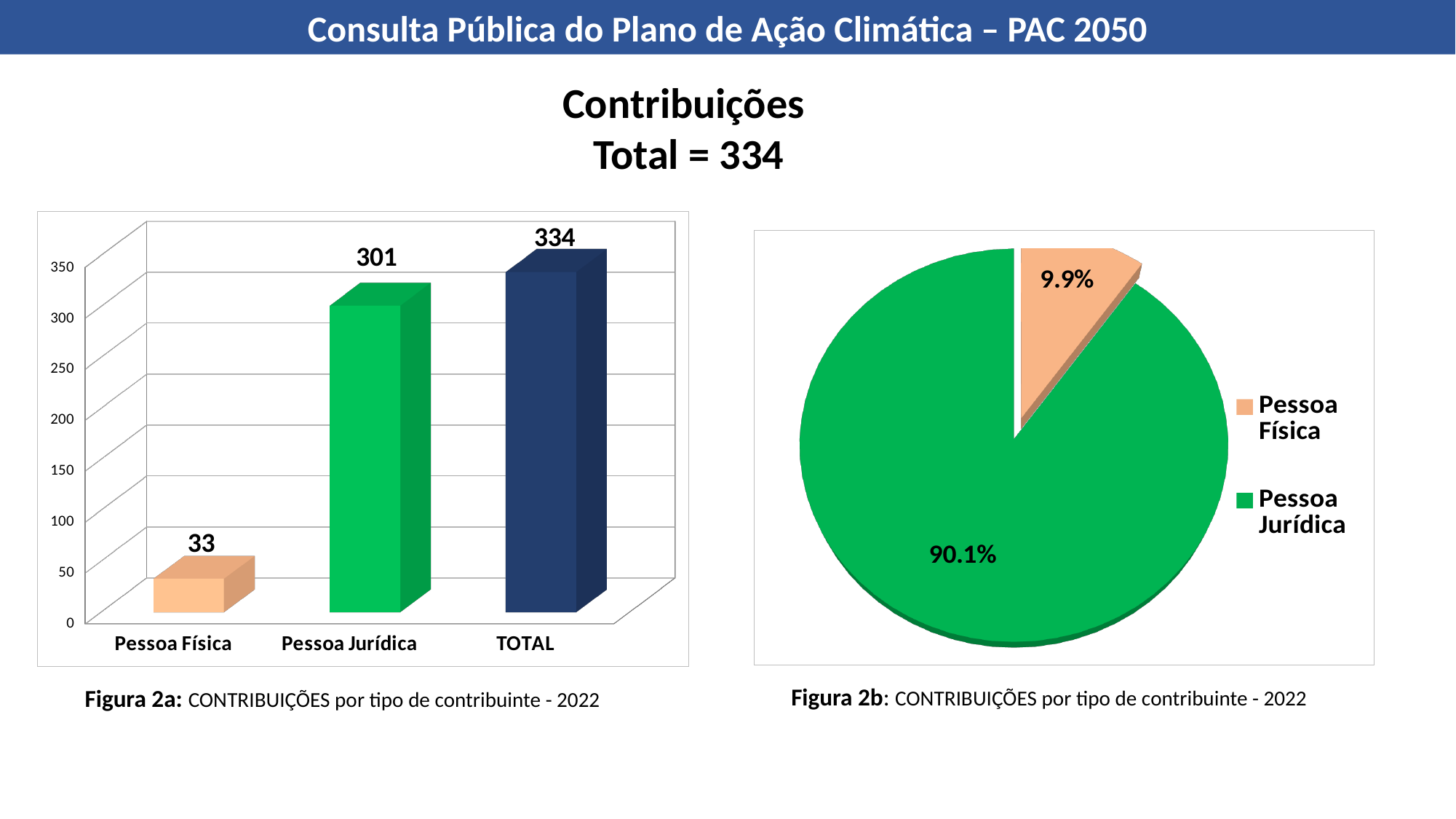
In the bar chart (Figura 2a), what is the value for Pessoa Física? 33 What kind of chart is Figura 2a? Bar chart In the bar chart (Figura 2a), which category has the highest value? TOTAL In the bar chart (Figura 2a), which is larger, Pessoa Física or Pessoa Jurídica? Pessoa Jurídica In the bar chart (Figura 2a), what is the value for TOTAL? 334 In the bar chart (Figura 2a), how many categories are shown on the x axis? 3 In the pie chart (Figura 2b), what share does Pessoa Jurídica have? 90.1% In the bar chart (Figura 2a), what is the difference between the values for Pessoa Jurídica and Pessoa Física? 268 In the pie chart (Figura 2b), what share does Pessoa Física have? 9.9% In the bar chart (Figura 2a), which category has the lowest value? Pessoa Física In the bar chart (Figura 2a), what is the value for Pessoa Jurídica? 301 In the pie chart (Figura 2b), how many entries does the legend list? 2